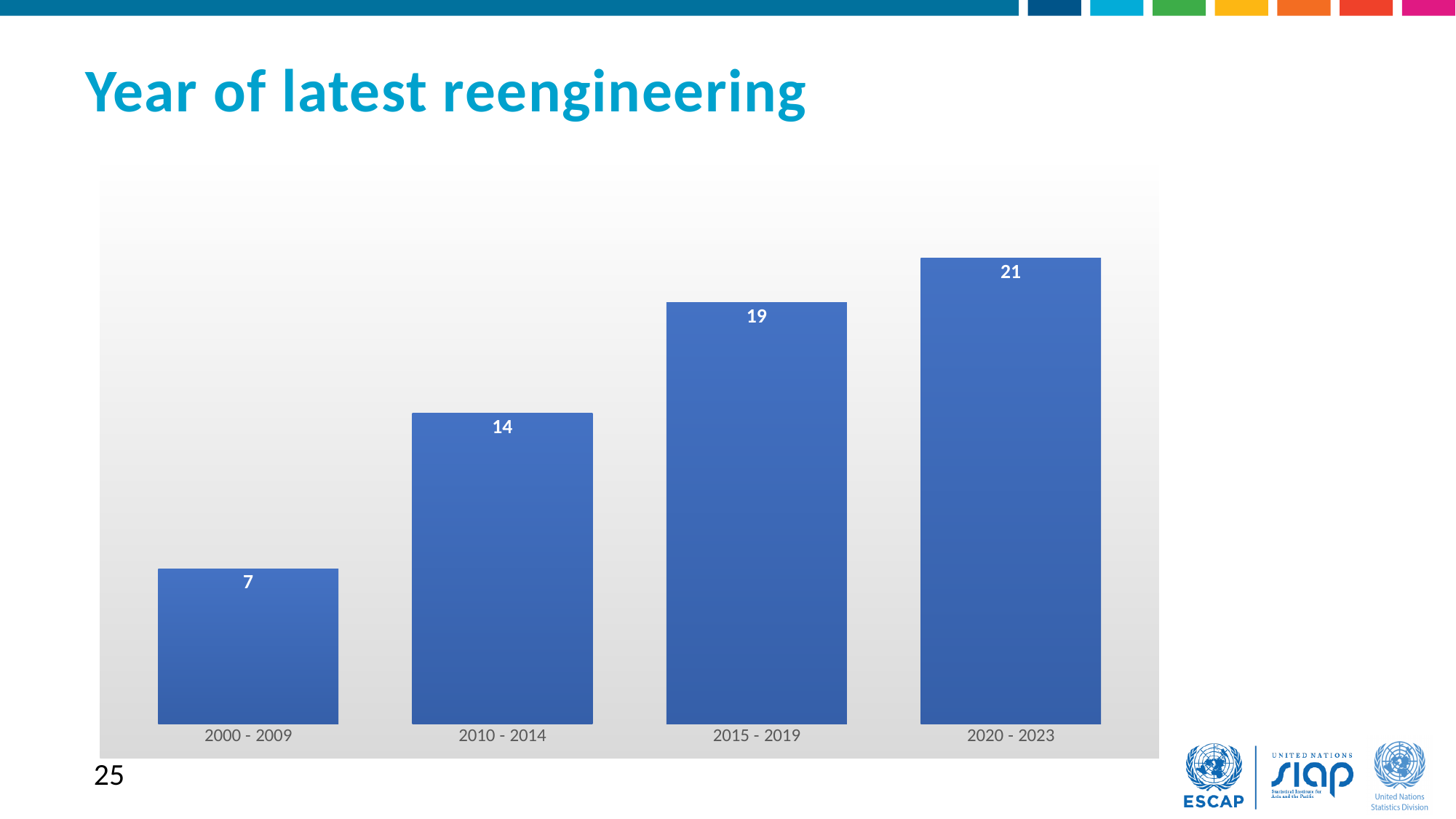
What is the difference between the values for 2020 - 2023 and 2000 - 2009? 14 What is the value for 2015 - 2019? 19 Which period has the highest value? 2020 - 2023 What kind of chart is shown on the slide? Bar chart What is the difference between the values for 2015 - 2019 and 2010 - 2014? 5 Which is larger, the value for 2010 - 2014 or the value for 2015 - 2019? 2015 - 2019 What is the value for 2010 - 2014? 14 How many periods are shown on the chart? 4 What is the value for 2000 - 2009? 7 Which period has the lowest value? 2000 - 2009 Do the values rise or fall from 2000 - 2009 to 2020 - 2023? Rise What is the value for 2020 - 2023? 21